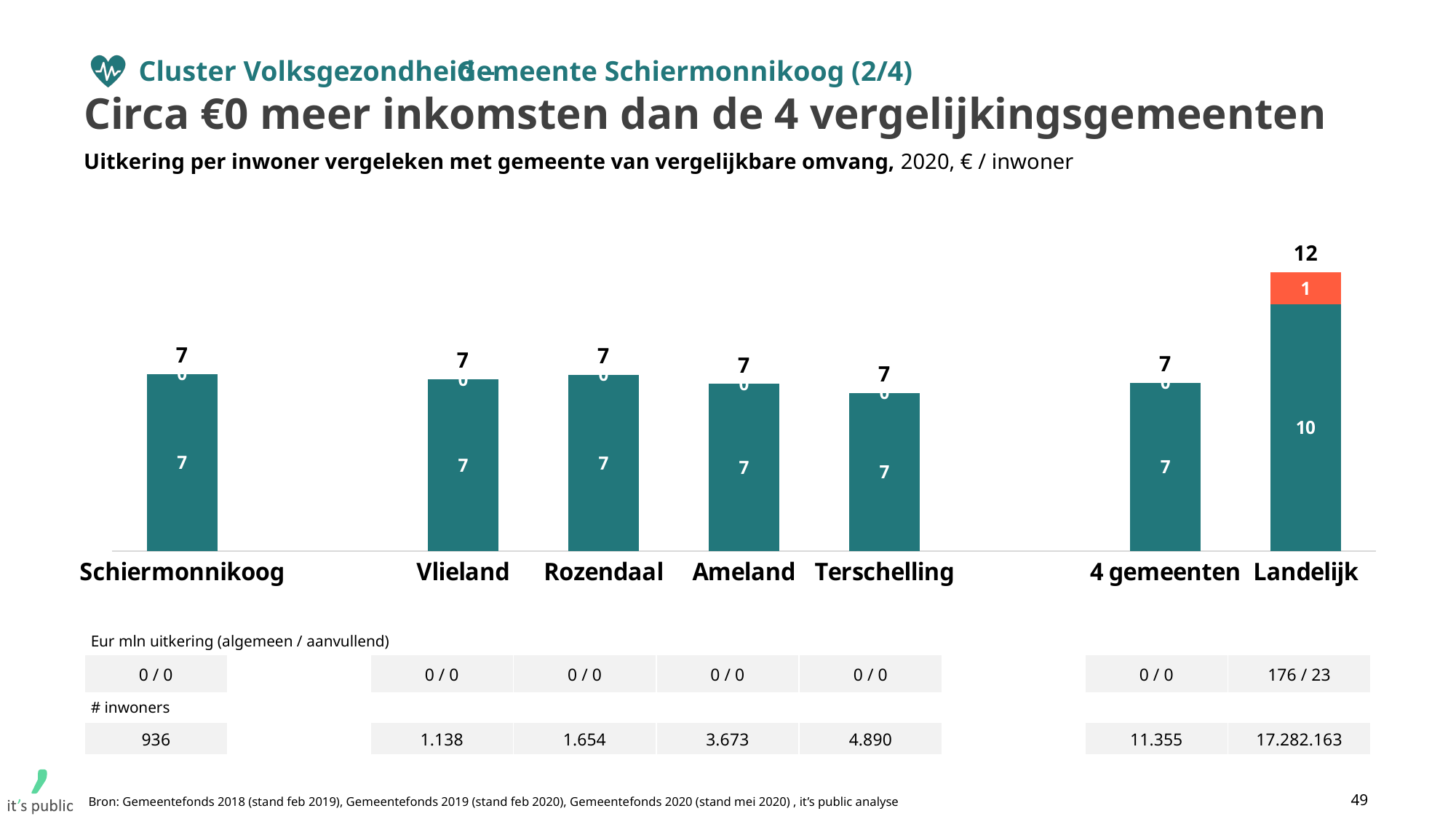
What is the value of the orange (upper) segment of the Landelijk bar? 1 What kind of chart is shown on the slide? Stacked bar chart What is the total value shown above the bar for Landelijk? 12 What is the value of the teal segment of the Terschelling bar? 7 Is the total for Landelijk larger or smaller than the total for Vlieland? larger What is the total value shown above the bar for Schiermonnikoog? 7 What is the number of inhabitants (# inwoners) listed for Ameland in the table below the chart? 3.673 What is the difference between the total for Landelijk and the total for 4 gemeenten? 5 What is the value of the teal (lower) segment of the Landelijk bar? 10 How many categories are shown on the x axis of the chart? 7 Which category has the highest total value? Landelijk